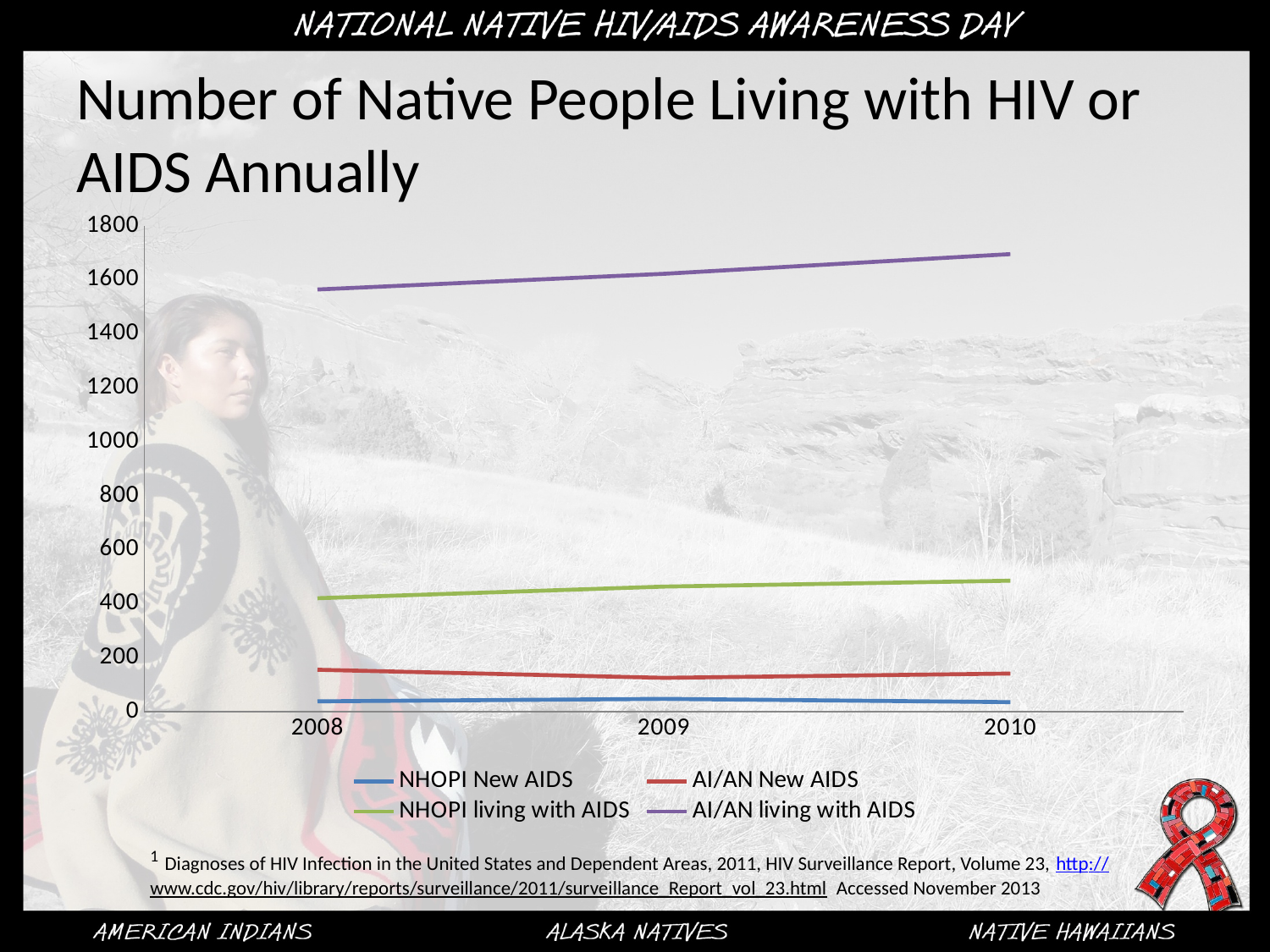
Which series has the lowest values across all years? NHOPI New AIDS Is the value for AI/AN living with AIDS in 2010 greater or less than 1600? greater Which series has the highest values across all years? AI/AN living with AIDS Is the value for AI/AN living with AIDS in 2008 greater or less than 1600? less Does the AI/AN living with AIDS line rise or fall from 2008 to 2010? rise How many years are shown on the x axis? 3 Is the value for NHOPI living with AIDS in 2010 greater or less than 400? greater Which is larger in 2009: AI/AN living with AIDS or NHOPI living with AIDS? AI/AN living with AIDS Does the NHOPI living with AIDS line rise or fall from 2008 to 2010? rise What kind of chart is shown on the slide? line chart How many series does the legend list? 4